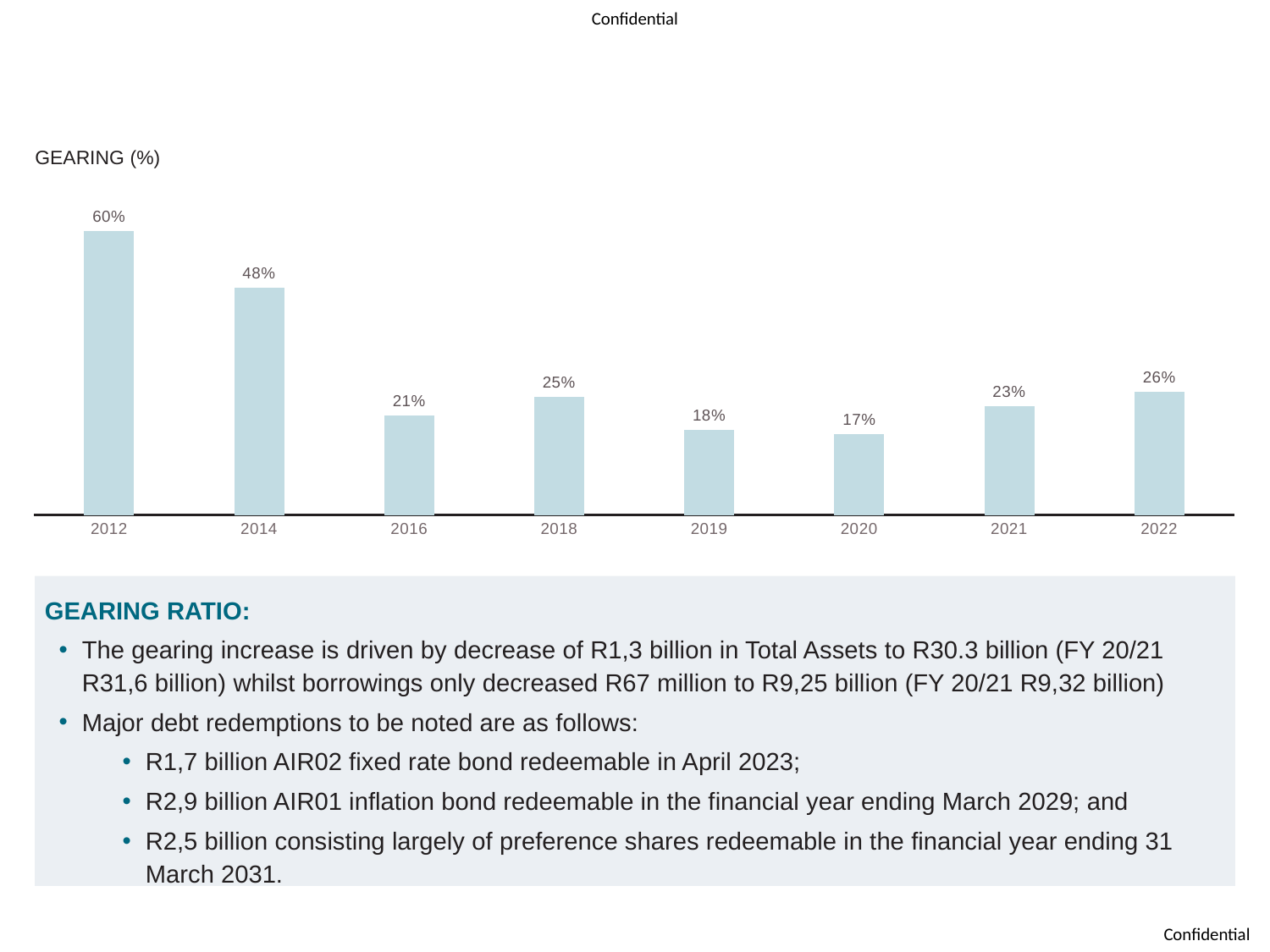
What is the difference in gearing between 2022 and 2021? 3% What kind of chart is shown on the slide? Bar chart What is the title of the chart? GEARING (%) What is the gearing percentage for 2020? 17% Which year has the highest gearing percentage? 2012 Which year has the lowest gearing percentage? 2020 What is the gearing percentage for 2012? 60% What is the gearing percentage for 2022? 26% Which year has a higher gearing percentage, 2018 or 2019? 2018 What is the difference in gearing between 2012 and 2014? 12% How many years are shown on the chart? 8 Does the gearing percentage rise or fall from 2012 to 2016? Fall